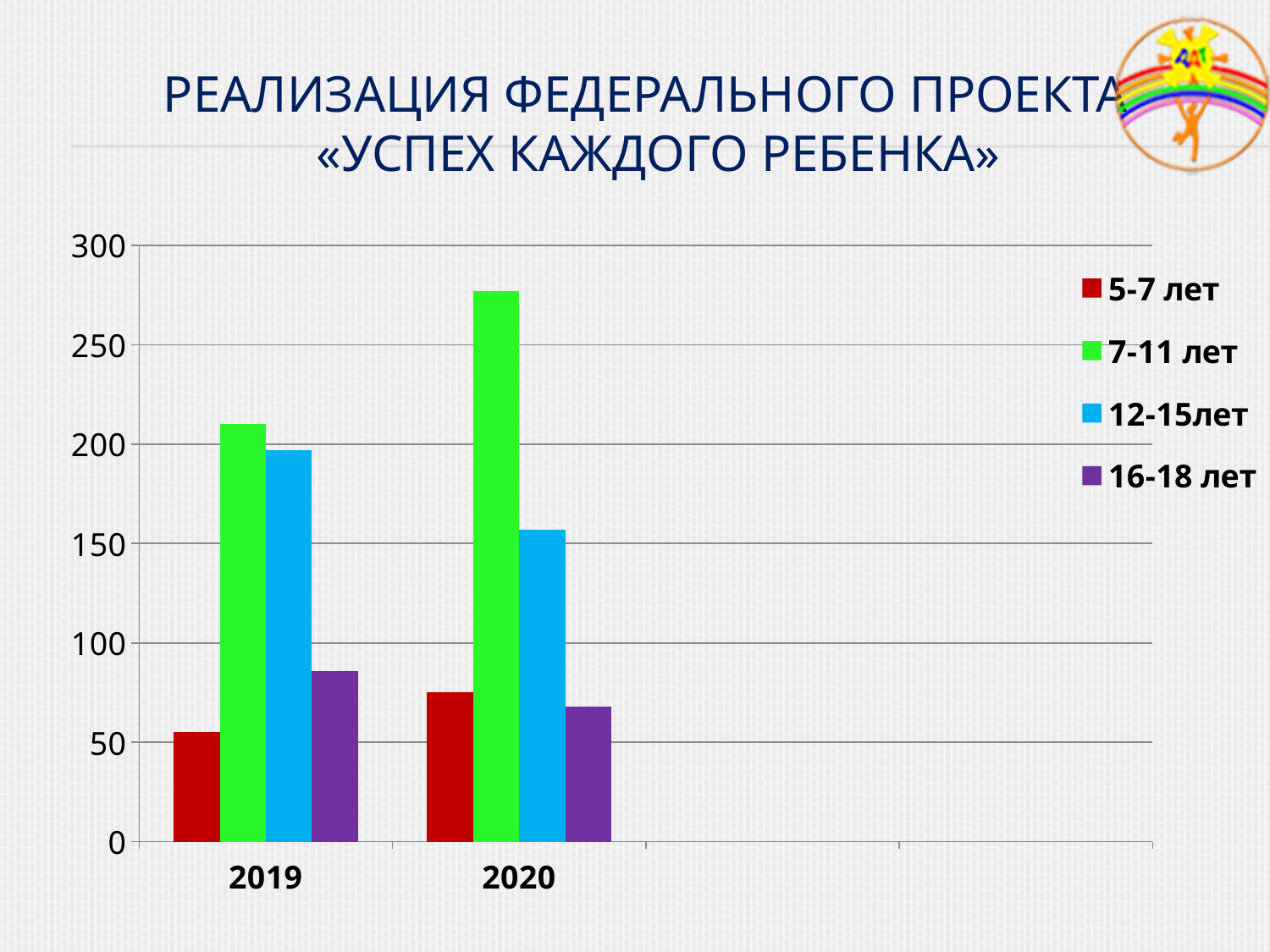
Is the value for 7-11 лет in 2020 greater or less than 250? greater Is the value for 16-18 лет in 2020 greater or less than 100? less Which colour represents the 16-18 лет series in the legend? purple How many categories are shown on the x axis? 2 How many series does the legend list? 4 Does the value for 7-11 лет rise or fall from 2019 to 2020? rise Is the value for 12-15лет in 2019 greater or less than 150? greater Which age group has the highest value in 2020? 7-11 лет Which age group has the lowest value in 2019? 5-7 лет Which is larger: the value for 12-15лет in 2019 or in 2020? 2019 Which age group has the highest value in 2019? 7-11 лет What kind of chart is shown on the slide? bar chart